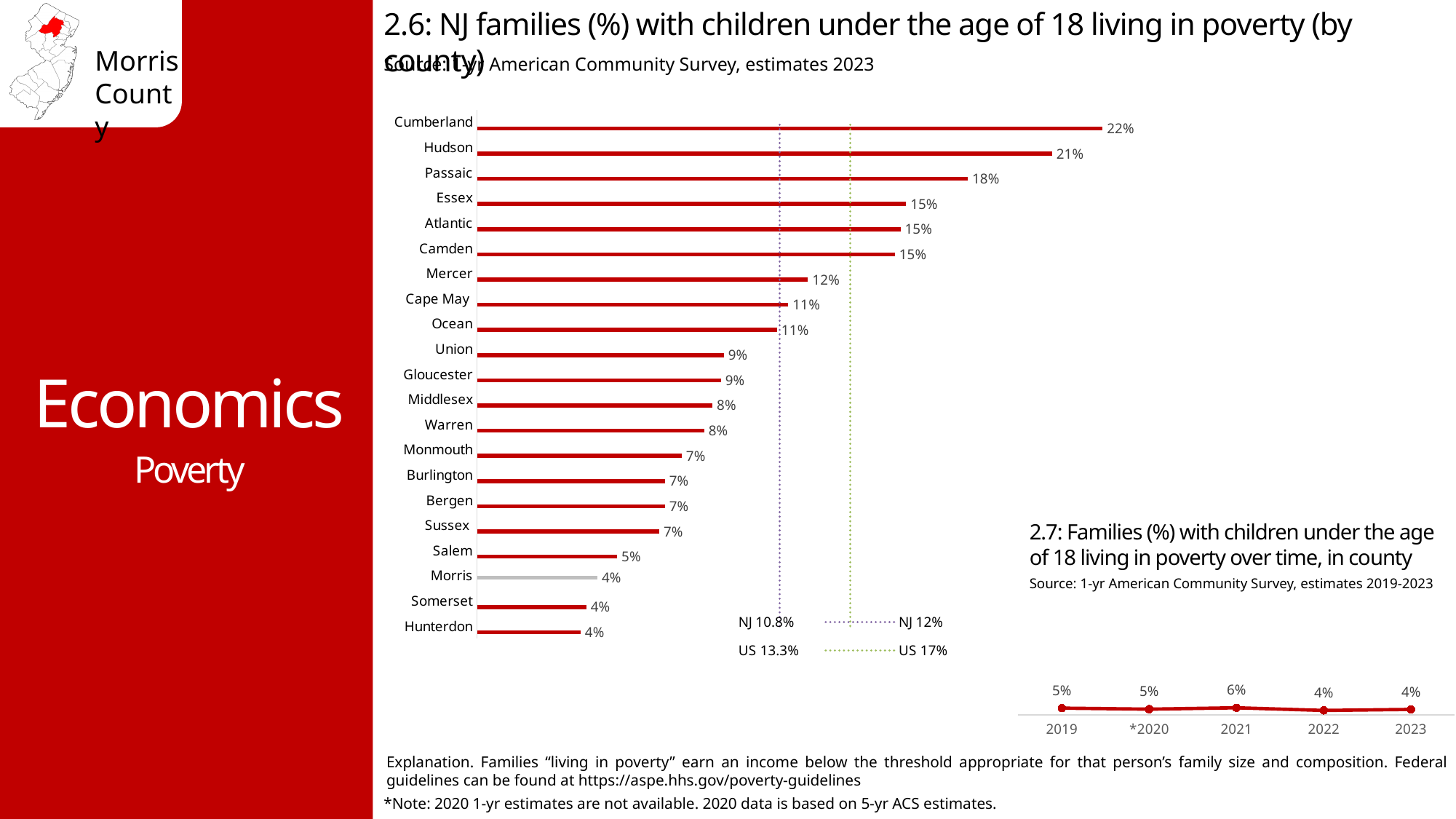
In chart 2.6, which is larger, the value for Mercer or the value for Union? Mercer In chart 2.7, what is the value for 2021? 6% What kind of chart is chart 2.6? Bar chart In chart 2.7, what is the difference between the values for 2021 and 2023? 2% In chart 2.6, what is the value for Passaic? 18% In chart 2.7, which year has the highest value? 2021 In chart 2.6, what is the difference between the values for Cumberland and Hudson? 1% In chart 2.6, how many counties are shown? 21 In chart 2.7, how many data points are plotted? 5 In chart 2.6, which county has the highest value? Cumberland In chart 2.6, what is the value for Morris? 4%